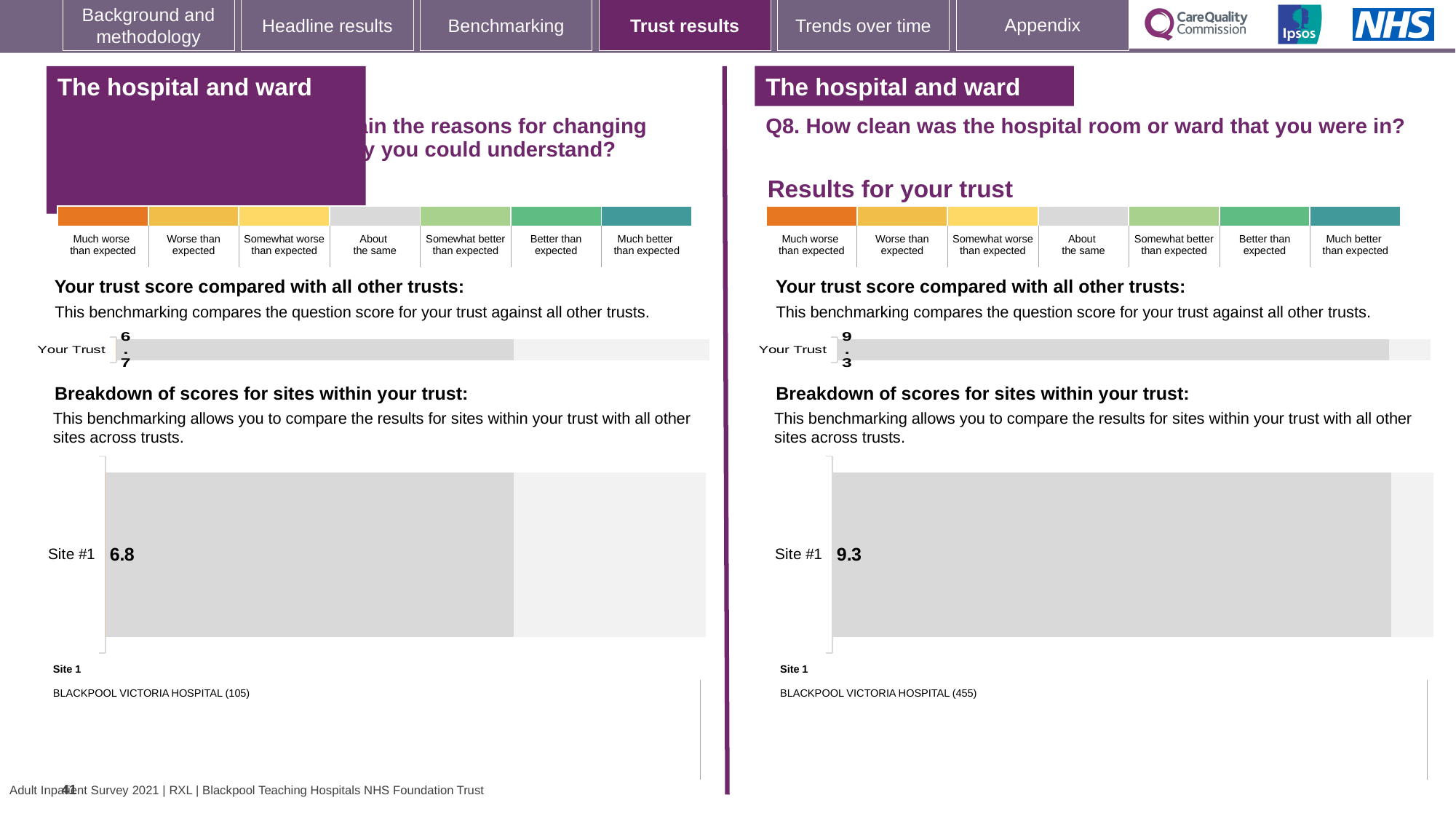
On the right-hand side of the slide, which hospital is listed as Site 1 below the chart? BLACKPOOL VICTORIA HOSPITAL (455) On the right-hand side of the slide (Q8), what is the score shown for Your Trust? 9.3 How many sites are shown in the 'Breakdown of scores for sites within your trust' chart on the right-hand side of the slide? 1 What survey question is the right-hand side of the slide about? Q8. How clean was the hospital room or ward that you were in? Which Site #1 score is higher: the one on the left-hand side of the slide or the one on the right-hand side (Q8)? The right-hand side (Q8) On the left-hand side of the slide, what is the difference between the Site #1 score and the Your Trust score? 0.1 On the right-hand side of the slide (Q8), what is the score shown for Site #1? 9.3 On the left-hand side of the slide, which has the higher score: Your Trust or Site #1? Site #1 What type of chart is used to show the Site #1 score on the right-hand side of the slide? Bar chart On the left-hand side of the slide, what is the score shown for Your Trust? 6.7 On the right-hand side of the slide (Q8), what is the difference between the Site #1 score and the Your Trust score? 0 On the left-hand side of the slide, what is the score shown for Site #1? 6.8